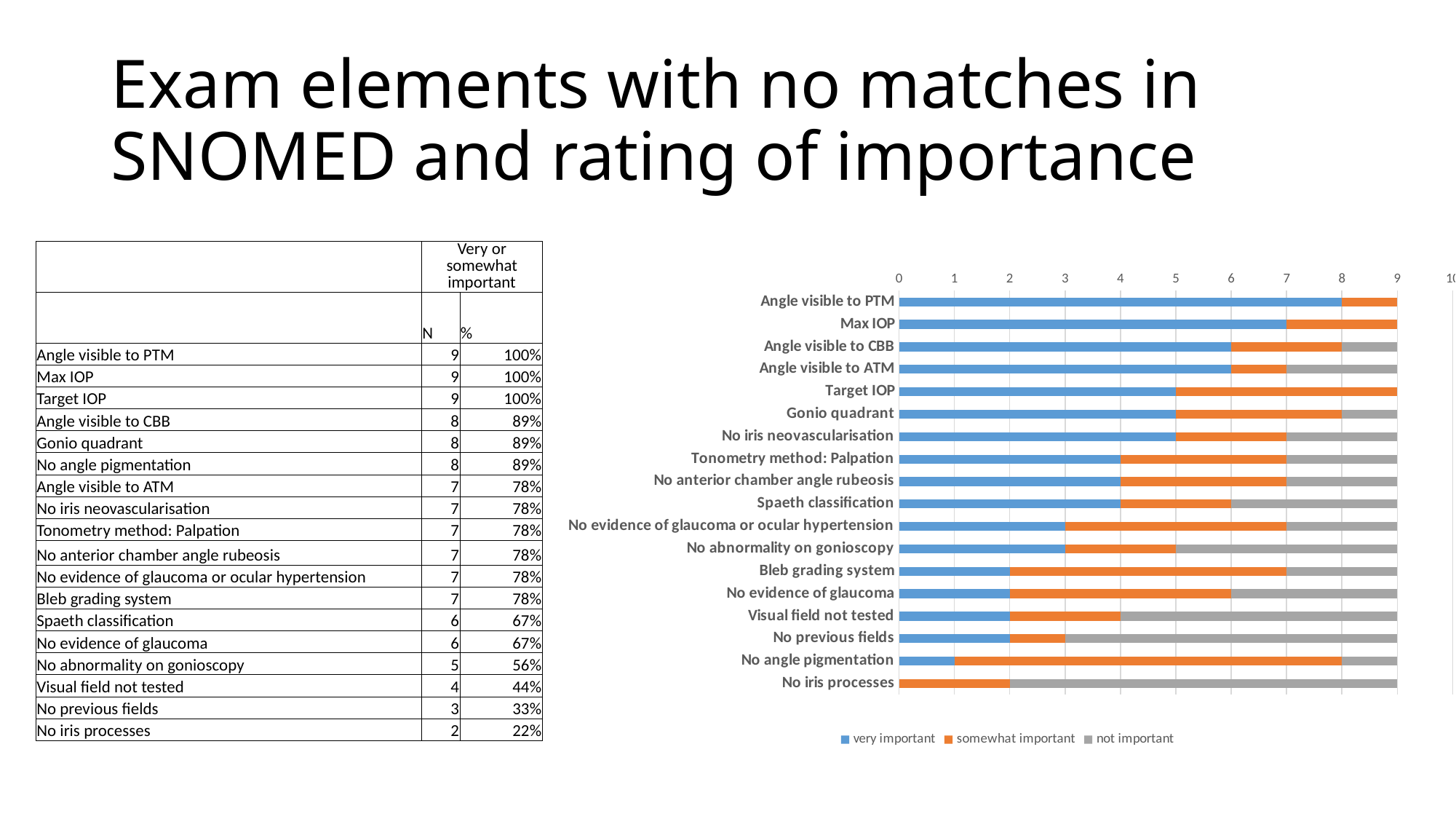
In the chart, is the 'very important' value for No angle pigmentation greater or less than 2? less How many exam elements (categories) are plotted in the chart? 18 How many series does the chart's legend list? 3 In the chart, what is the total length of the stacked bar for Target IOP? 9 In the chart, what is the 'very important' value for Angle visible to CBB? 6 What kind of chart is shown on the right of the slide? stacked bar chart In the chart, what is the 'very important' value for Max IOP? 7 Which exam element has the longest 'very important' segment in the chart? Angle visible to PTM Which exam element has no 'very important' segment at all in the chart? No iris processes Which colour represents 'not important' in the chart's legend? grey In the chart, which has the larger 'very important' value: Gonio quadrant or Bleb grading system? Gonio quadrant In the chart, what is the difference between the 'very important' values for Angle visible to PTM and No previous fields? 6